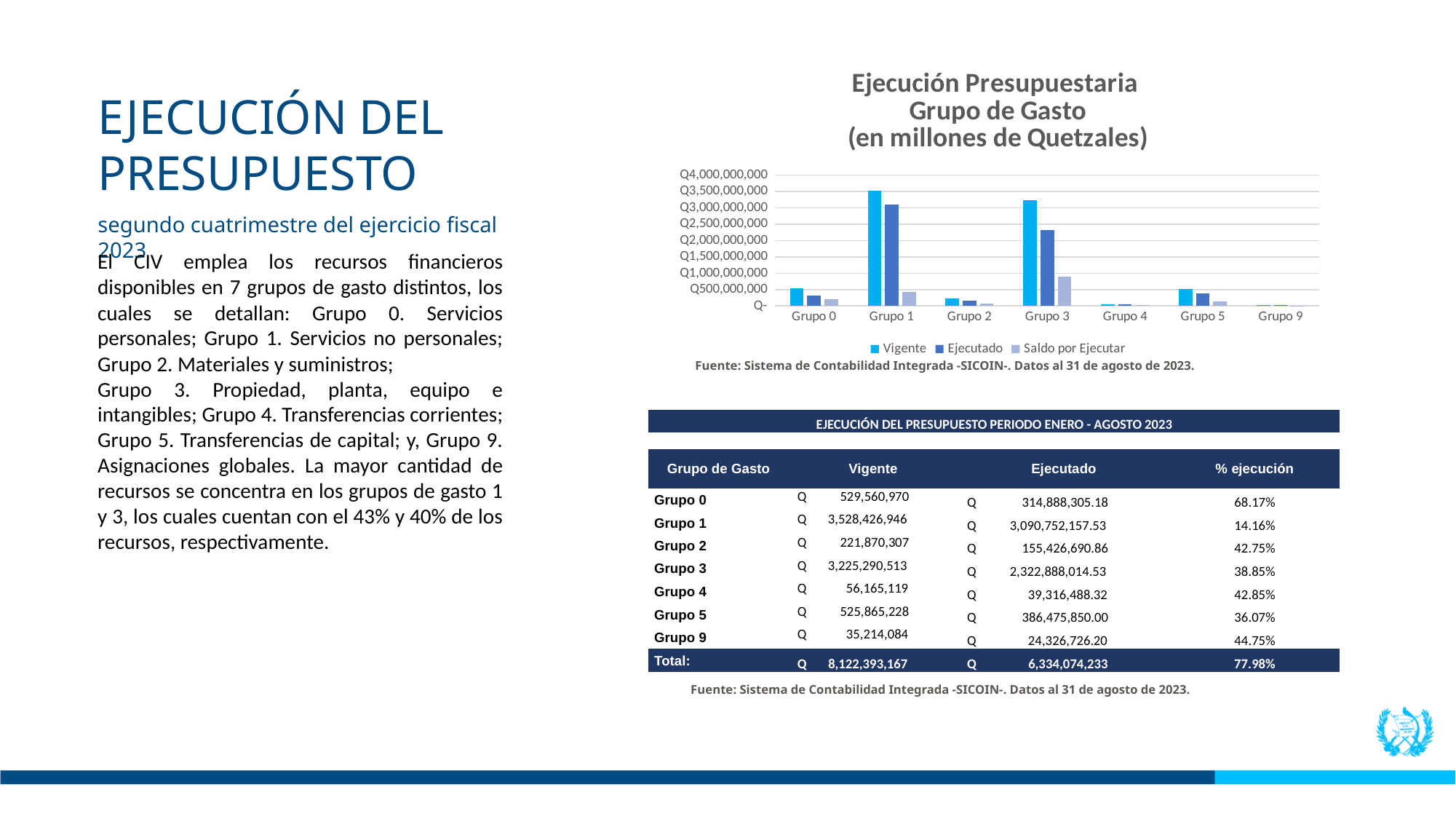
Is the Saldo por Ejecutar value for Grupo 3 greater or less than Q1,000,000,000? less Is the Vigente value for Grupo 2 greater or less than Q500,000,000? less Which group has the highest Ejecutado value in the chart? Grupo 1 Which group has the highest Vigente value in the chart? Grupo 1 Is the Ejecutado value for Grupo 3 greater or less than Q2,500,000,000? less Which is larger in the chart: the Ejecutado value for Grupo 1 or for Grupo 3? Grupo 1 Which is larger in the chart: the Vigente value for Grupo 0 or for Grupo 2? Grupo 0 What are the three series listed in the chart legend? Vigente, Ejecutado, Saldo por Ejecutar What kind of chart is shown on the slide? bar chart How many series does the chart legend list? 3 How many groups (categories) are shown on the x axis of the chart? 7